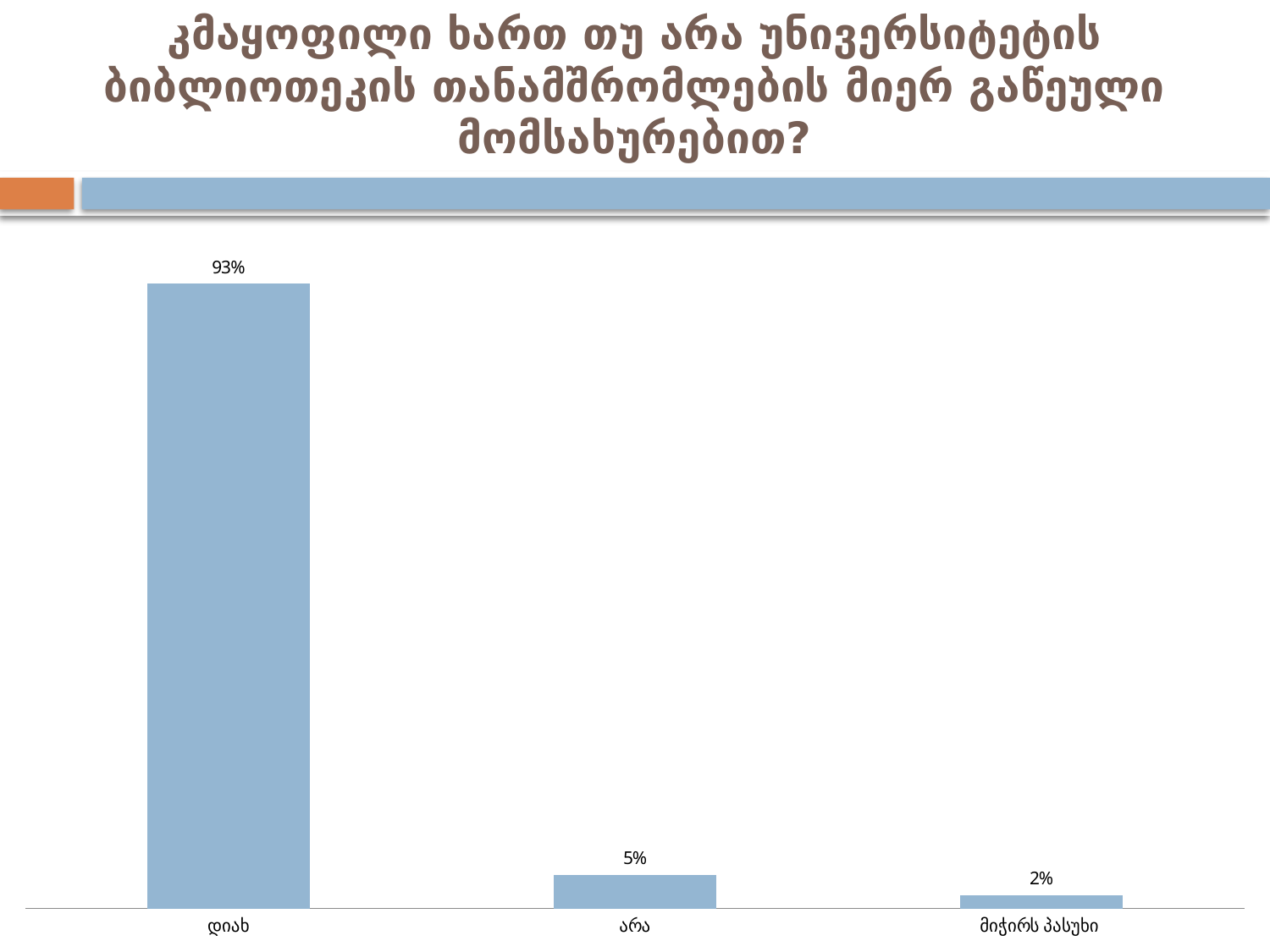
What is the value for მიჭირს პასუხი? 2% What is the difference between the values for დიახ and არა? 88% Do the values rise or fall from left to right along the x axis? fall What kind of chart is shown on the slide? bar chart What is the value for არა? 5% What colour are the bars in the chart? light blue Which category has the highest value? დიახ What is the value for დიახ? 93% Which is larger, the value for არა or the value for მიჭირს პასუხი? არა How many categories are shown on the x axis? 3 Which category has the lowest value? მიჭირს პასუხი What is the difference between the values for არა and მიჭირს პასუხი? 3%